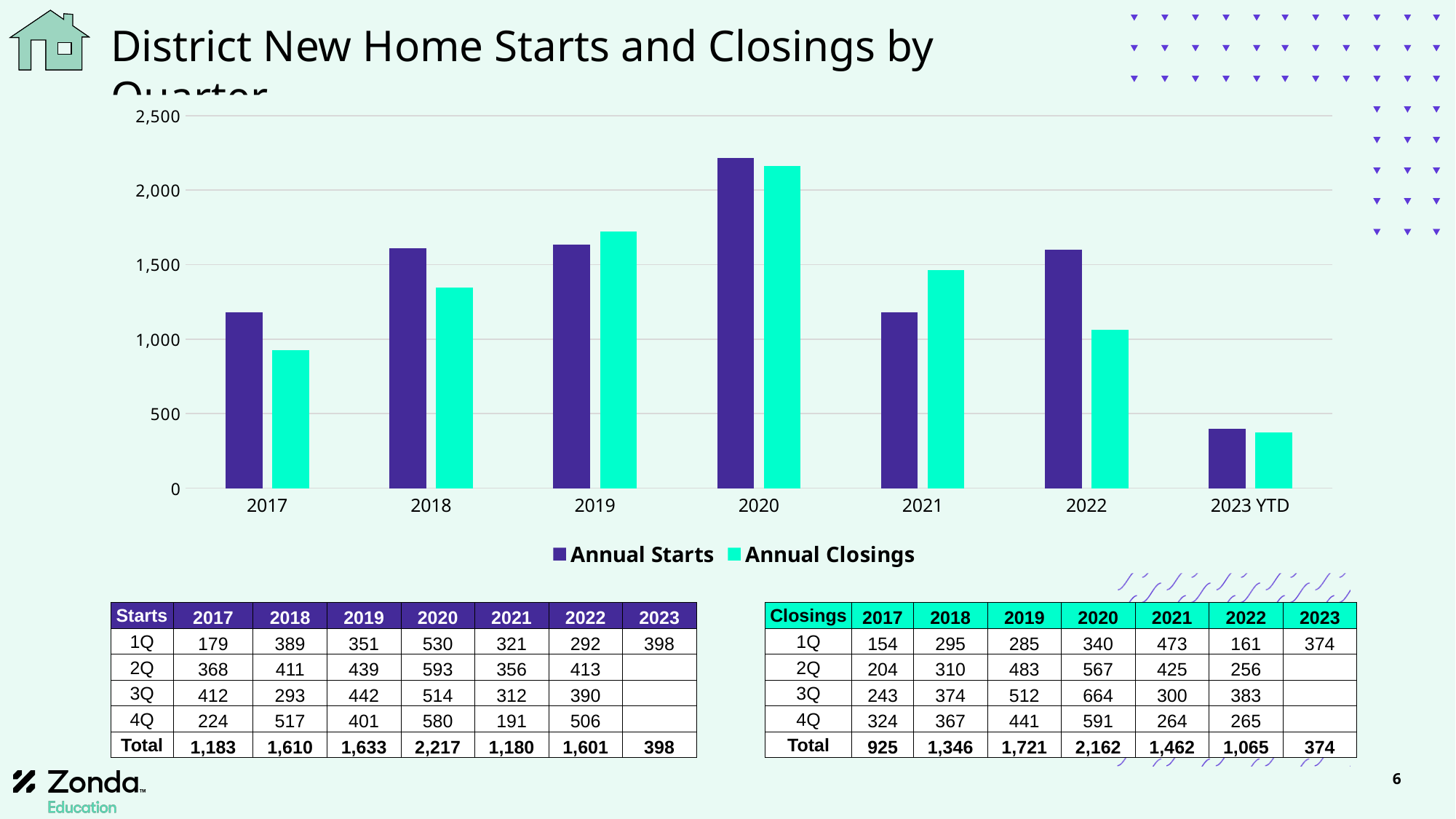
Is the Annual Starts value for 2022 greater or less than 1,500? greater Using the table totals, what is the difference between Annual Starts and Annual Closings in 2020? 55 How many year categories are shown along the x axis of the chart? 7 What is the Annual Starts value for 2020, as given in the Starts table total? 2,217 Is the Annual Closings value for 2017 greater or less than 1,000? less In which year is the Annual Closings bar the lowest? 2023 YTD How many series does the chart legend list? 2 For 2021, which is larger: Annual Starts or Annual Closings? Annual Closings What is the Annual Closings value for 2019, as given in the Closings table total? 1,721 Do the Annual Starts values rise or fall from 2017 to 2020? rise What kind of chart is shown on the slide? bar chart In which year is the Annual Starts bar the highest? 2020